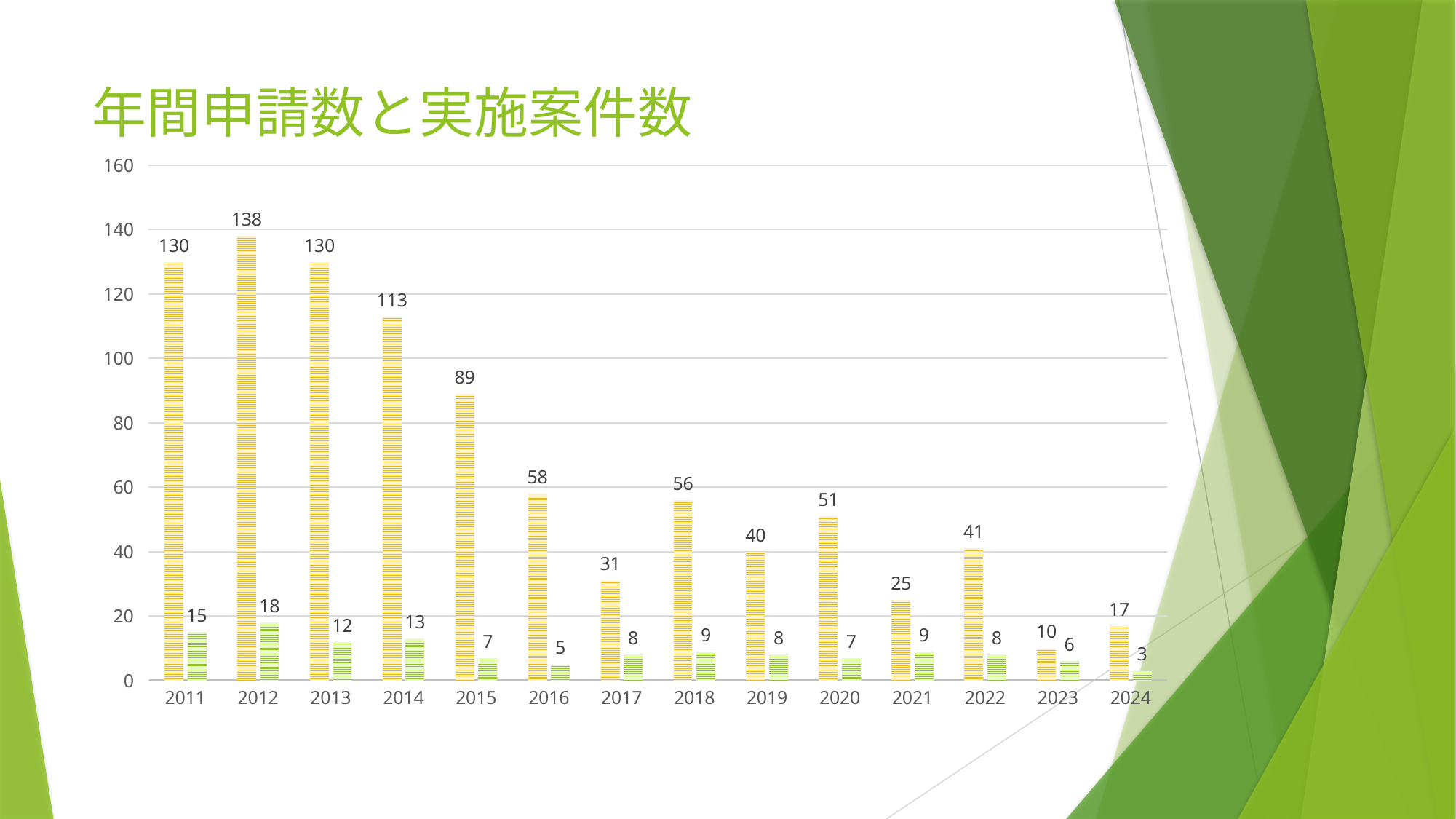
What is the difference between the orange bar values for 2011 and 2015? 41 Which year has the lowest green bar? 2024 Which year has the lowest orange bar? 2023 Which year has the highest orange bar? 2012 What is the title of the chart? 年間申請数と実施案件数 Do the orange bar values generally rise or fall from 2011 to 2024? Fall What is the value of the green bar for 2014? 13 What is the value of the orange bar for 2020? 51 How many years are shown on the x axis? 14 Which is larger, the orange bar for 2018 or the orange bar for 2016? 2016 What kind of chart is shown on the slide? Bar chart What is the value of the orange bar for 2012? 138